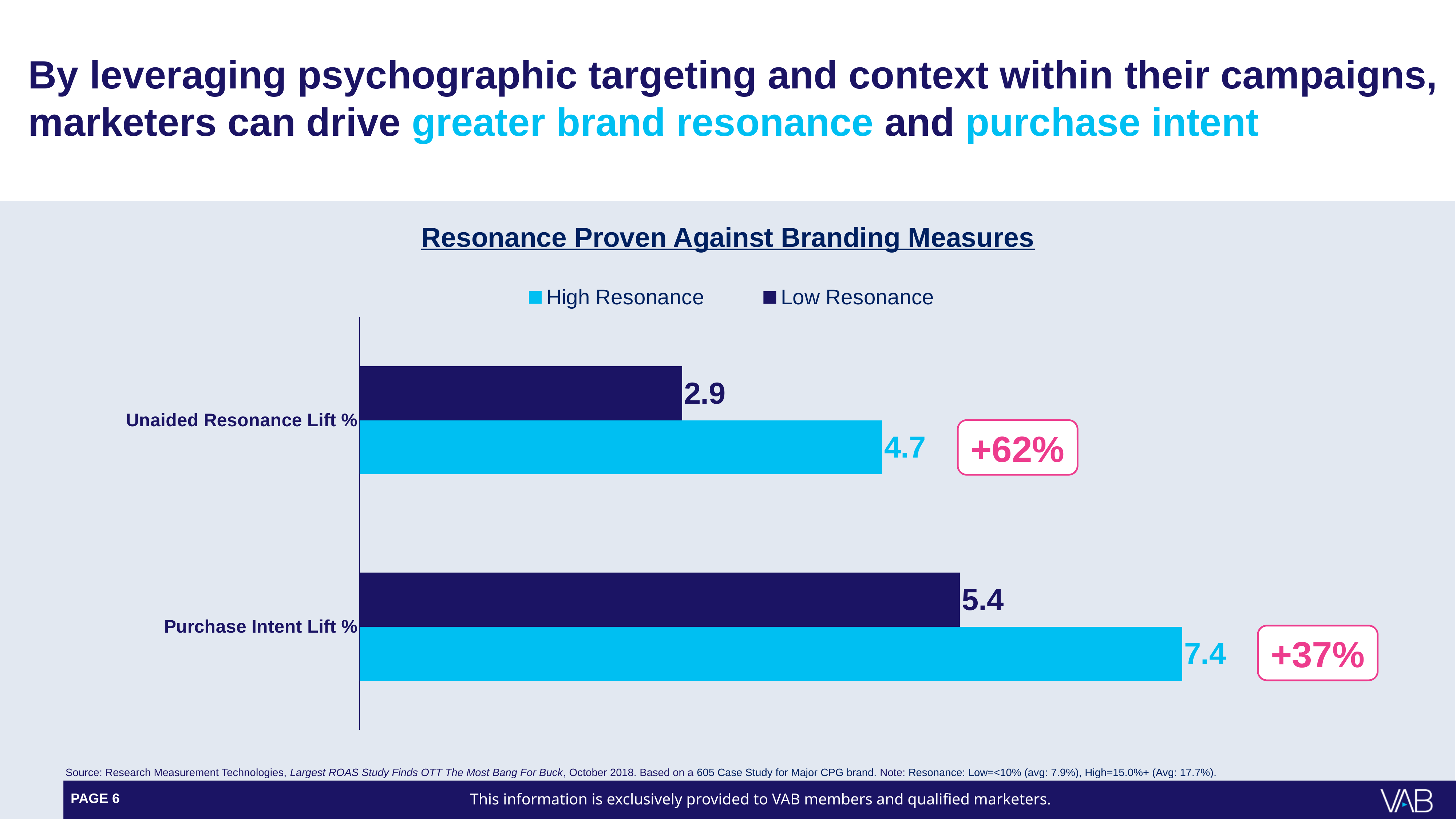
What is the High Resonance value for Unaided Resonance Lift %? 4.7 What kind of chart is shown on the slide? Bar chart What is the difference between the High Resonance and Low Resonance values for Purchase Intent Lift %? 2.0 How many series does the legend list? 2 What is the High Resonance value for Purchase Intent Lift %? 7.4 What is the difference between the High Resonance and Low Resonance values for Unaided Resonance Lift %? 1.8 For Unaided Resonance Lift %, which is larger: High Resonance or Low Resonance? High Resonance How many categories are shown on the chart? 2 What is the Low Resonance value for Unaided Resonance Lift %? 2.9 What is the Low Resonance value for Purchase Intent Lift %? 5.4 Which category has the highest High Resonance value? Purchase Intent Lift % Which category has the lowest Low Resonance value? Unaided Resonance Lift %